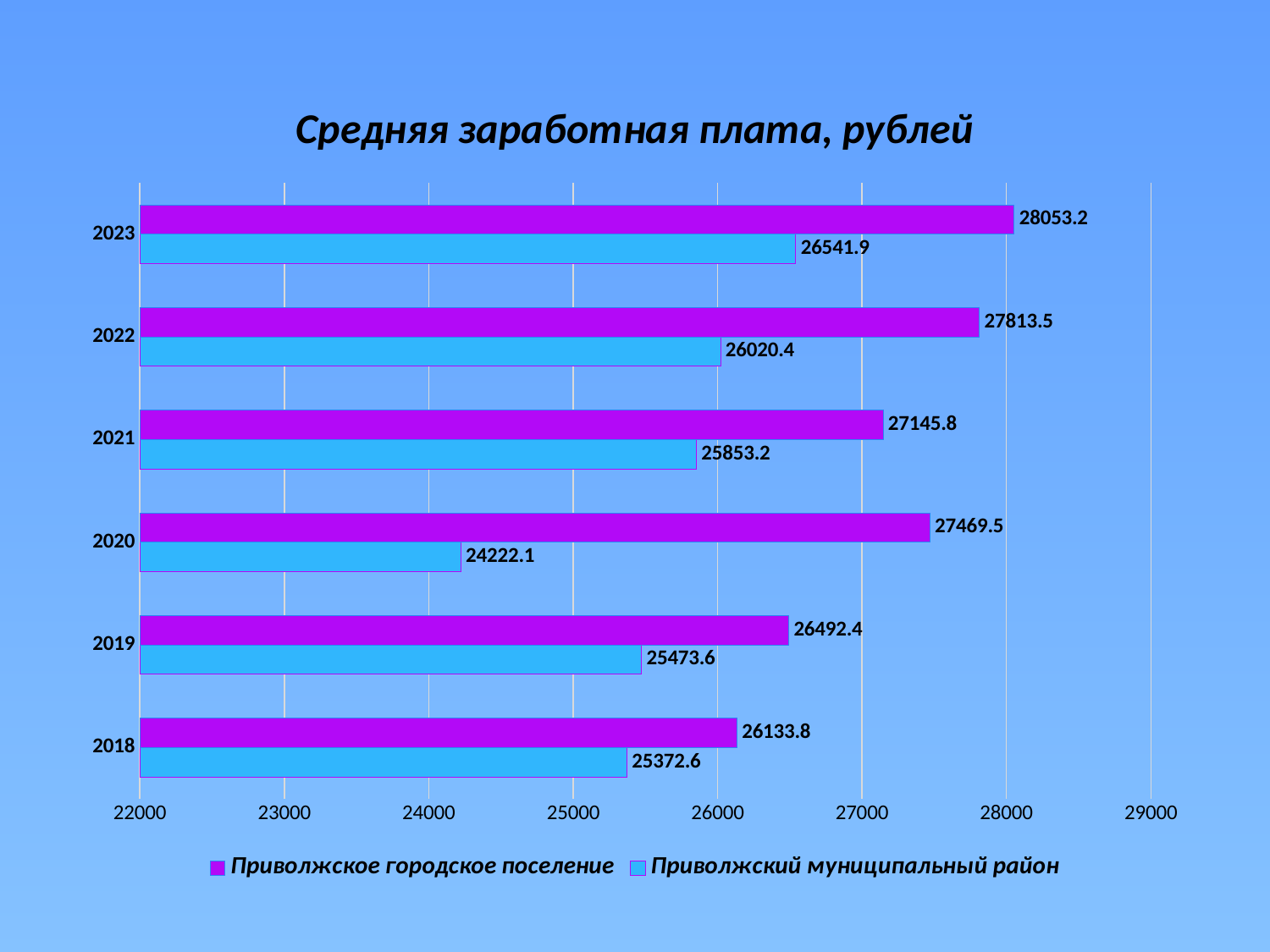
What is the value for Приволжское городское поселение in 2023? 28053.2 What is the difference between Приволжское городское поселение and Приволжский муниципальный район in 2020? 3247.4 Which is larger in 2022: Приволжское городское поселение or Приволжский муниципальный район? Приволжское городское поселение How many series does the legend list? 2 In which year is the value for Приволжское городское поселение the highest? 2023 What type of chart is shown on the slide? bar chart How many years are shown on the chart? 6 What is the value for Приволжский муниципальный район in 2020? 24222.1 In which year is the value for Приволжский муниципальный район the lowest? 2020 What is the value for Приволжское городское поселение in 2019? 26492.4 Do the values for Приволжский муниципальный район rise or fall from 2021 to 2023? rise Is the value for Приволжский муниципальный район in 2021 greater or less than 26000? less